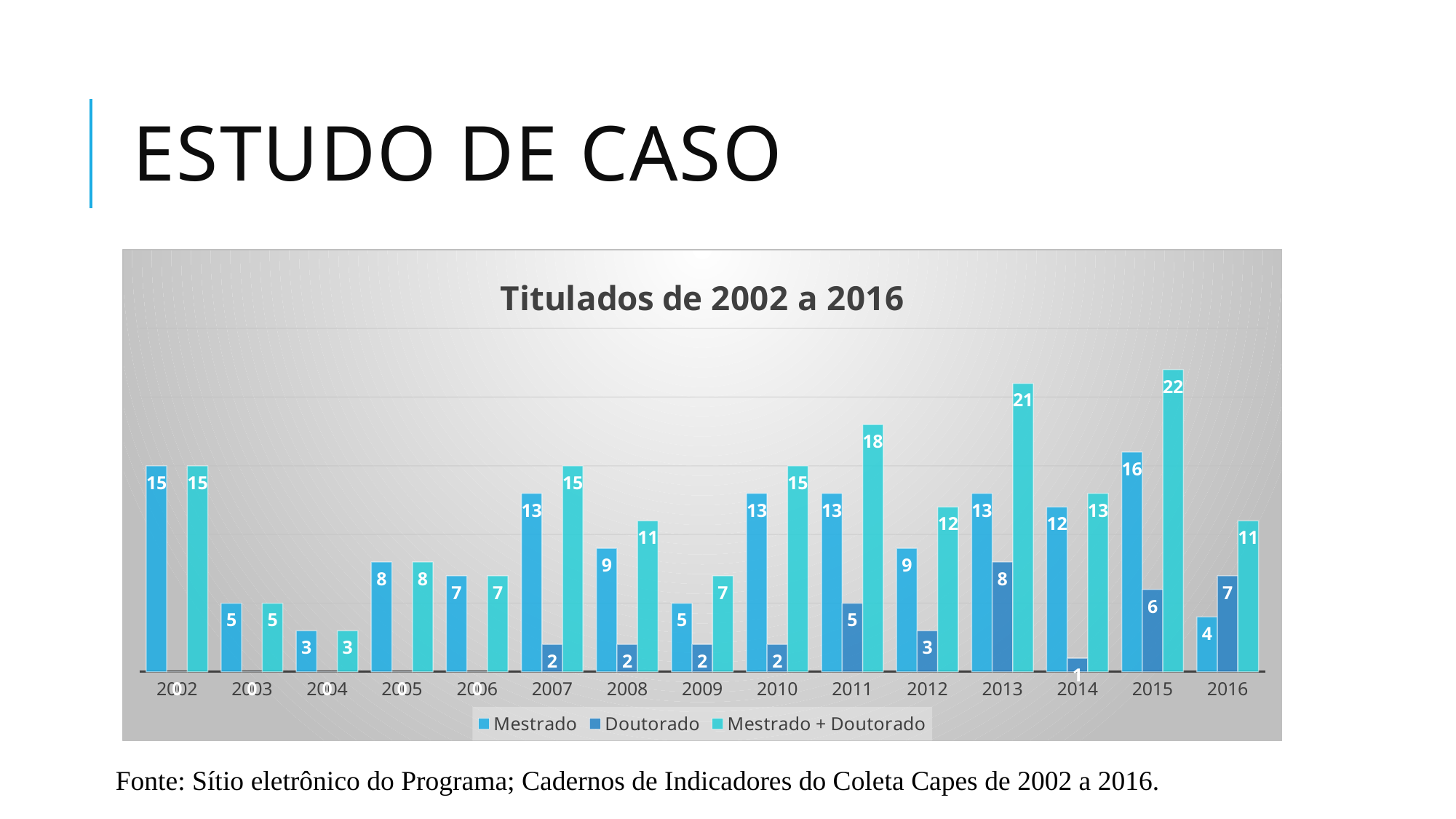
How many years are shown on the x axis? 15 What is the Mestrado + Doutorado value for 2011? 18 What is the Doutorado value for 2013? 8 What is the Mestrado value for 2015? 16 What is the difference between the Mestrado + Doutorado values for 2013 and 2012? 9 In which year is the Mestrado value lowest? 2004 Which is larger in 2016, the Mestrado value or the Doutorado value? Doutorado In which year is the Mestrado + Doutorado value highest? 2015 How many series does the legend list? 3 Does the Doutorado value rise or fall from 2014 to 2016? Rise What kind of chart is shown on the slide? Bar chart What is the title of the chart? Titulados de 2002 a 2016